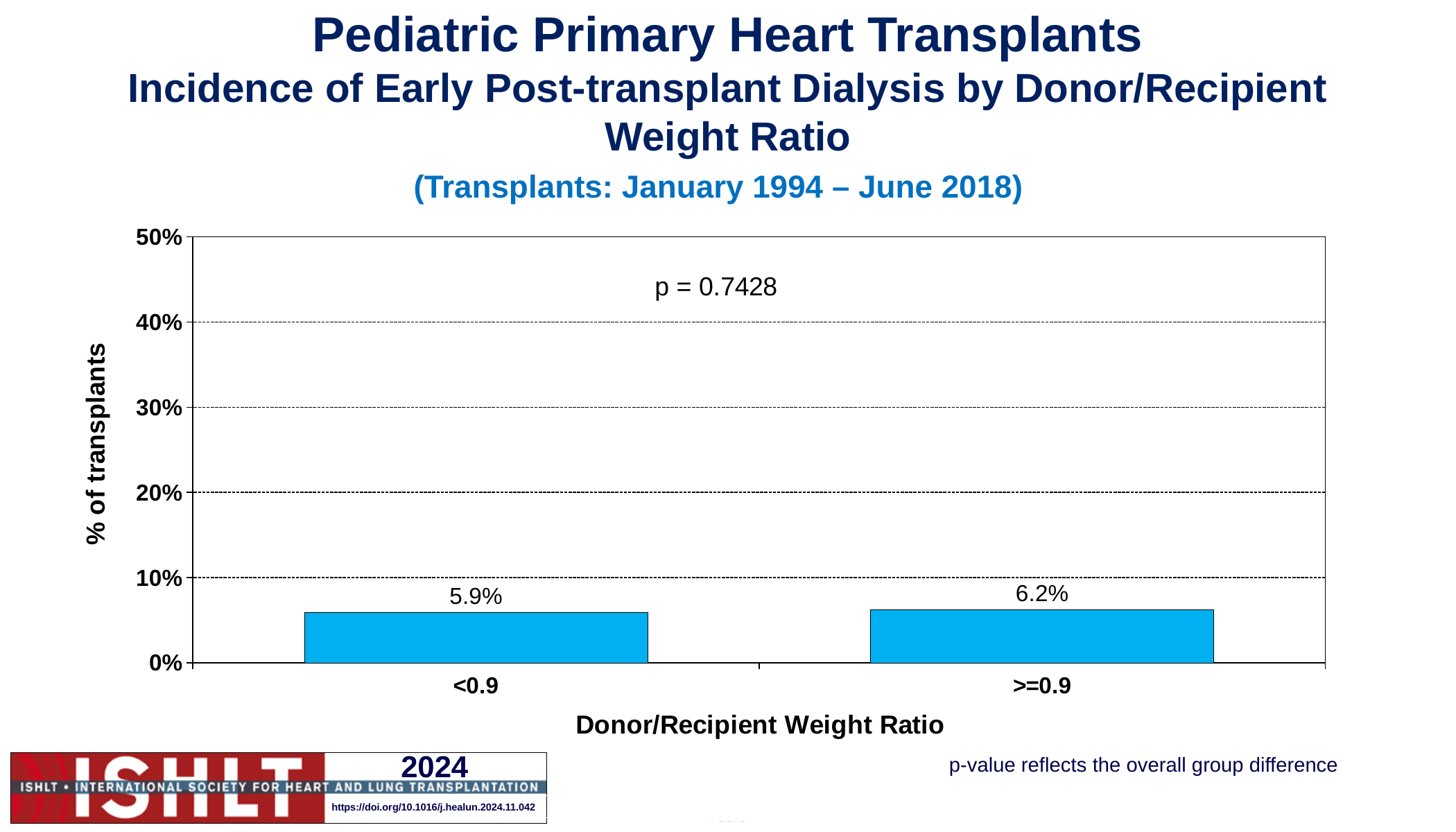
Is the value for the >=0.9 group greater or less than 10%? less What is the label of the y axis? % of transplants What p-value is printed on the chart? p = 0.7428 Which donor/recipient weight ratio group has the higher incidence of early post-transplant dialysis? >=0.9 Which donor/recipient weight ratio group has the lower incidence of early post-transplant dialysis? <0.9 What kind of chart is shown on the slide? bar chart What is the percentage of transplants with early post-transplant dialysis for the >=0.9 donor/recipient weight ratio group? 6.2% What is the difference in percentage points between the >=0.9 group and the <0.9 group? 0.3% How many donor/recipient weight ratio categories are shown on the x axis? 2 Is the value for the <0.9 group greater or less than 10%? less What is the maximum value shown on the y axis? 50% What is the percentage of transplants with early post-transplant dialysis for the <0.9 donor/recipient weight ratio group? 5.9%